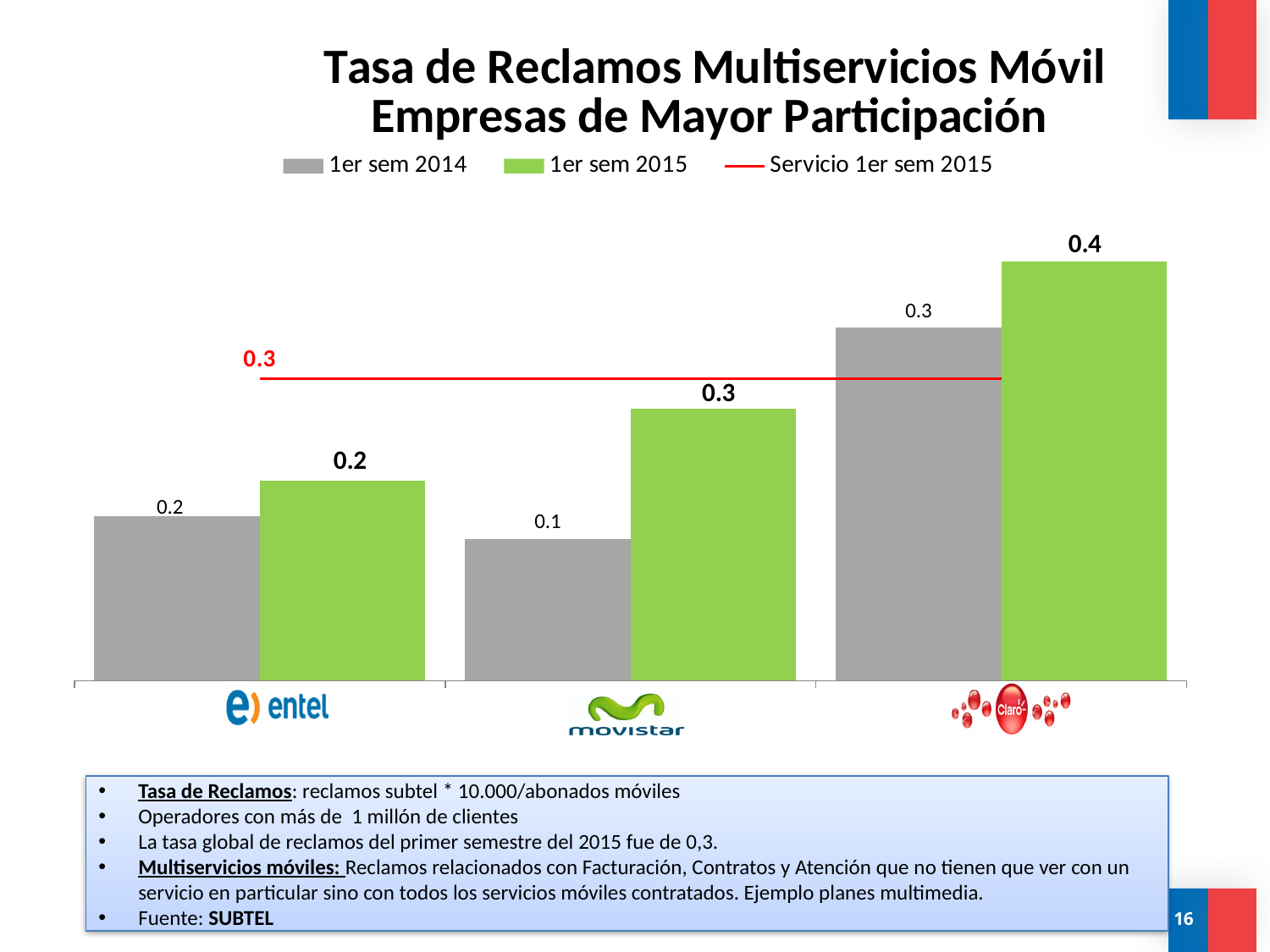
What value does the Servicio 1er sem 2015 line show? 0.3 What is the value for Claro in the 1er sem 2015 series? 0.4 Which company has the lowest value in the 1er sem 2014 series? Movistar Which is larger, the 1er sem 2015 value for Claro or for Movistar? Claro Which company has the highest value in the 1er sem 2015 series? Claro What is the value for Claro in the 1er sem 2014 series? 0.3 What is the value for Movistar in the 1er sem 2014 series? 0.1 What is the difference between the 1er sem 2015 values for Claro and Entel? 0.2 What is the value for Entel in the 1er sem 2015 series? 0.2 How many entries does the legend list? 3 What kind of chart is shown on the slide? Combination bar and line chart How many companies are shown on the x axis? 3